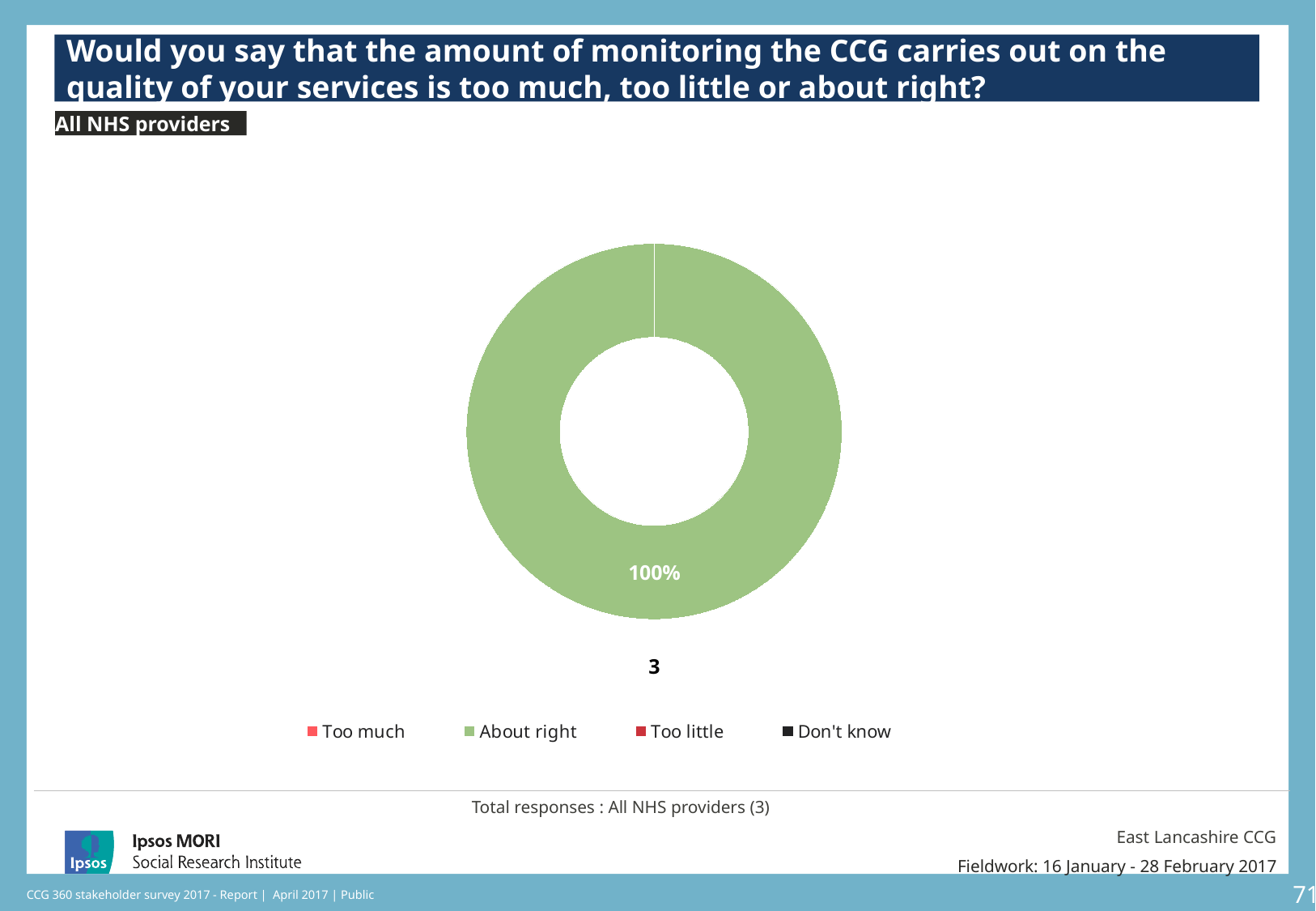
What kind of chart is shown on the slide? Doughnut chart Is the value for 'About right' greater or less than 50%? greater What percentage of All NHS providers said the amount of monitoring is 'About right'? 100% Which response category has the largest share of the chart? About right What share of the chart does the 'About right' slice take up? 100% What is the total number of responses shown beneath the chart? 3 Which legend entry is shown in green? About right How many entries does the chart legend list? 4 Which group of respondents does the chart cover, according to the label above it? All NHS providers How many response categories are visible as slices in the chart? 1